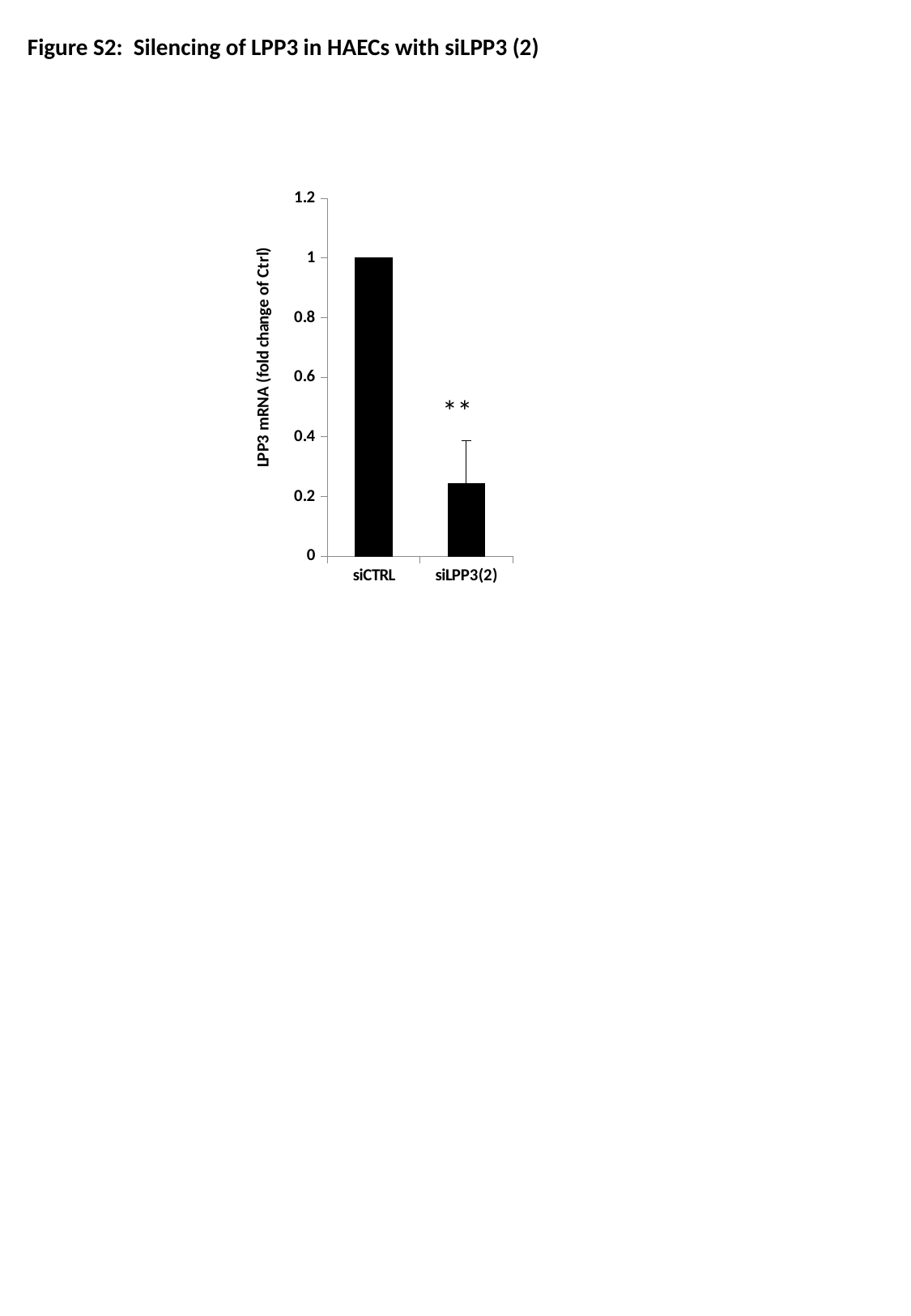
Is the value for siLPP3(2) greater or less than 0.4? less Which is larger, the value for siCTRL or the value for siLPP3(2)? siCTRL Which category has the highest value? siCTRL Which bar has the asterisks (**) above it? siLPP3(2) Which category has the lowest value? siLPP3(2) Do the values rise or fall from siCTRL to siLPP3(2)? fall How many categories are plotted on the x axis? 2 Is the value for siCTRL greater or less than 0.8? greater Is the value for siLPP3(2) greater or less than 0.2? greater What is the value for siCTRL? 1 What kind of chart is shown on the slide? bar chart What is the label of the y axis? LPP3 mRNA (fold change of Ctrl)